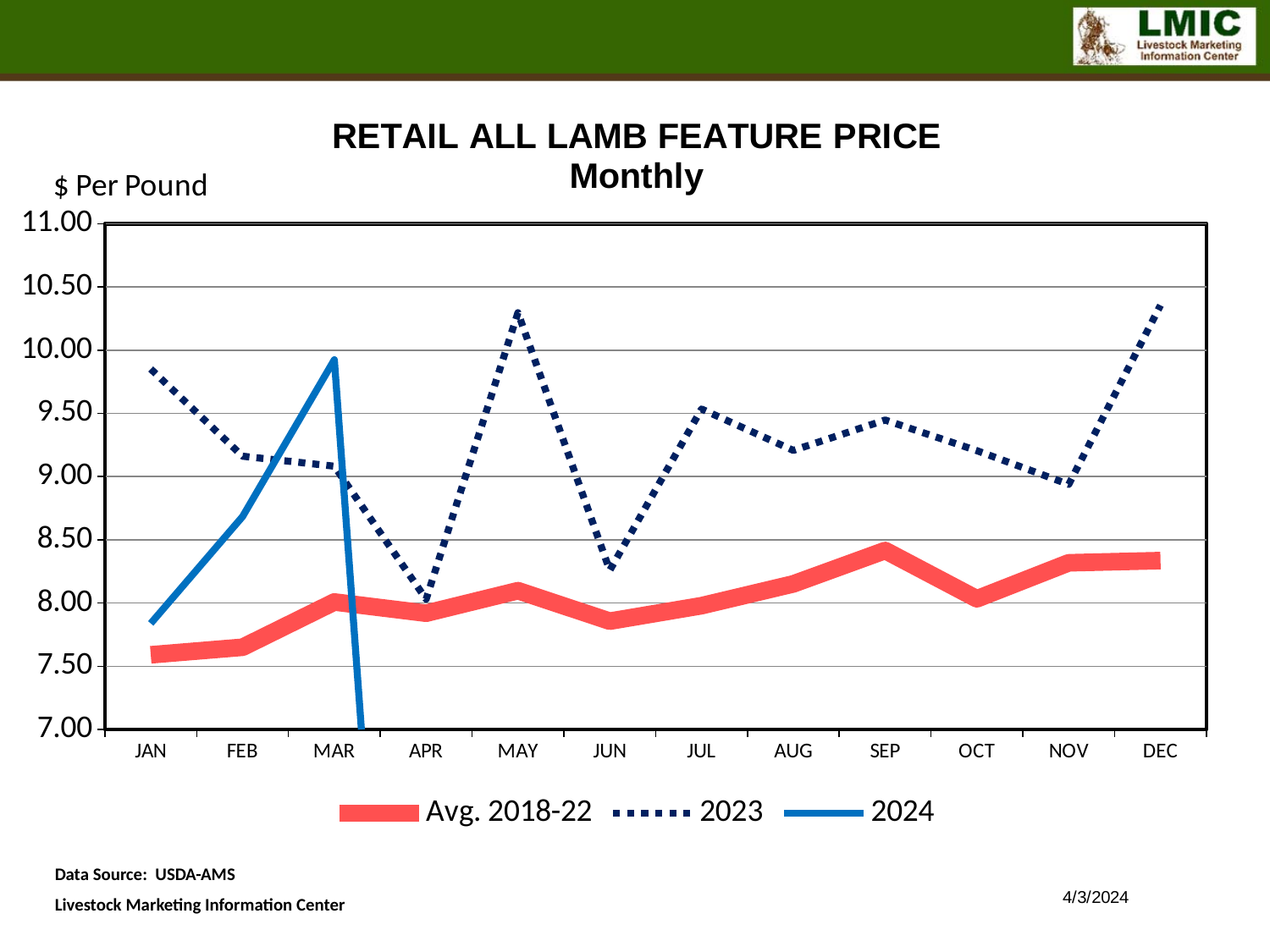
How many months are shown along the x axis? 12 In MAR, which series has the larger value, 2023 or 2024? 2024 Is the 2023 value for JAN greater or less than 9.50? greater Which month has the lowest value for the Avg. 2018-22 series? JAN Is the 2023 value for MAY greater or less than 10.00? greater Which month has the lowest value for the 2023 series? APR What unit is shown on the y axis of the chart? $ Per Pound Which month has the highest value for the 2024 series? MAR How many series does the legend list? 3 Is the 2024 value for JAN greater or less than 8.00? less What kind of chart is shown on the slide? line chart Does the 2024 series rise or fall from JAN to MAR? rise